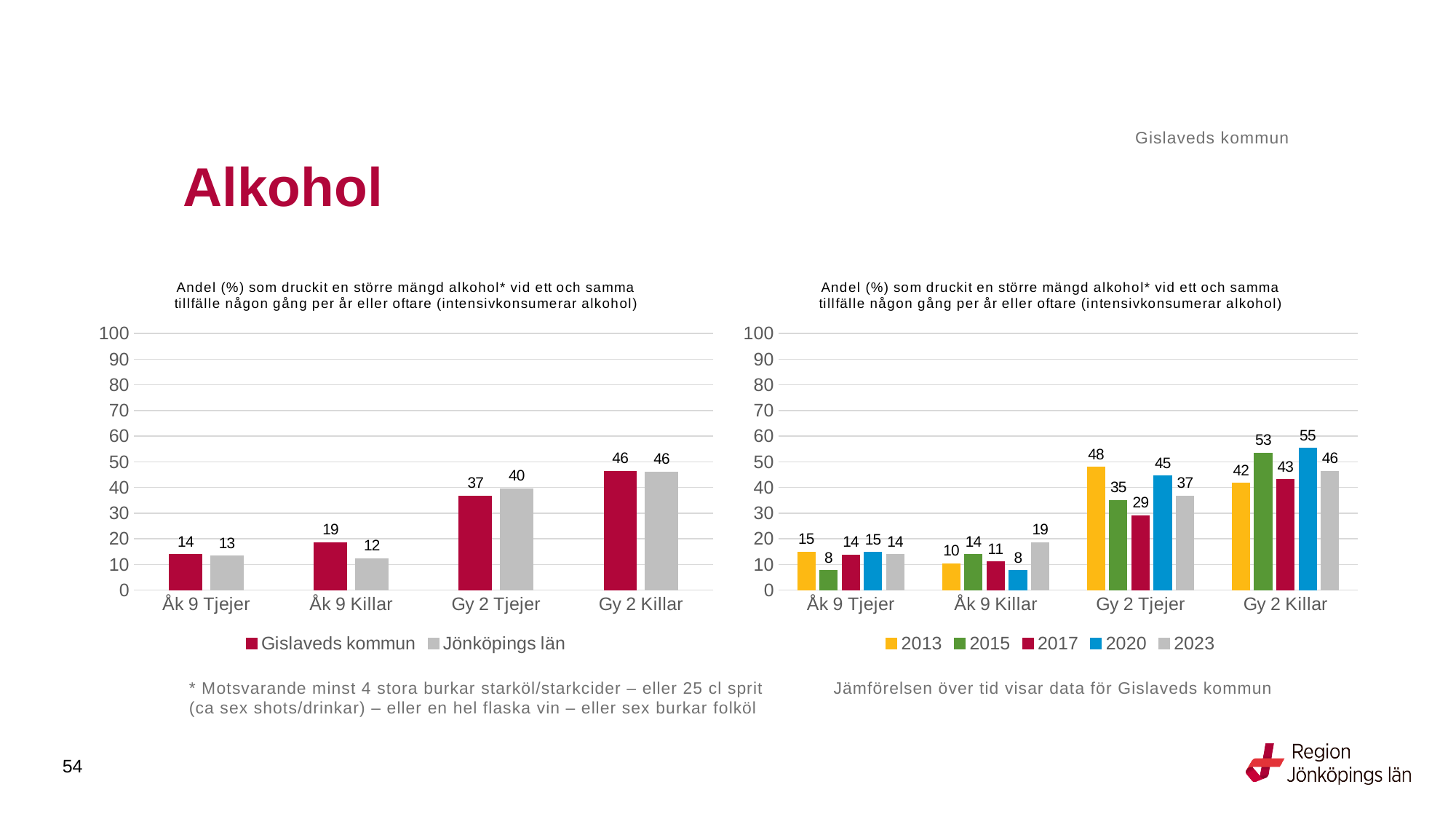
What kind of chart is the left chart? Bar chart In the right chart, what is the difference between the 2013 and 2023 values for Gy 2 Tjejer? 11 In the left chart, what is the difference between Gislaveds kommun and Jönköpings län for Åk 9 Killar? 7 In the left chart, what is the value for Jönköpings län for Gy 2 Tjejer? 40 In the left chart, which category has the highest value for Gislaveds kommun? Gy 2 Killar In the left chart, what is the value for Gislaveds kommun for Åk 9 Killar? 19 In the left chart, how many series does the legend list? 2 In the right chart, how many series does the legend list? 5 In the right chart, what is the value for 2015 for Åk 9 Tjejer? 8 In the right chart, which year has the lowest value for Gy 2 Tjejer? 2017 In the right chart, which is larger for Åk 9 Killar: the value for 2023 or the value for 2013? 2023 In the right chart, what is the value for 2020 for Gy 2 Killar? 55